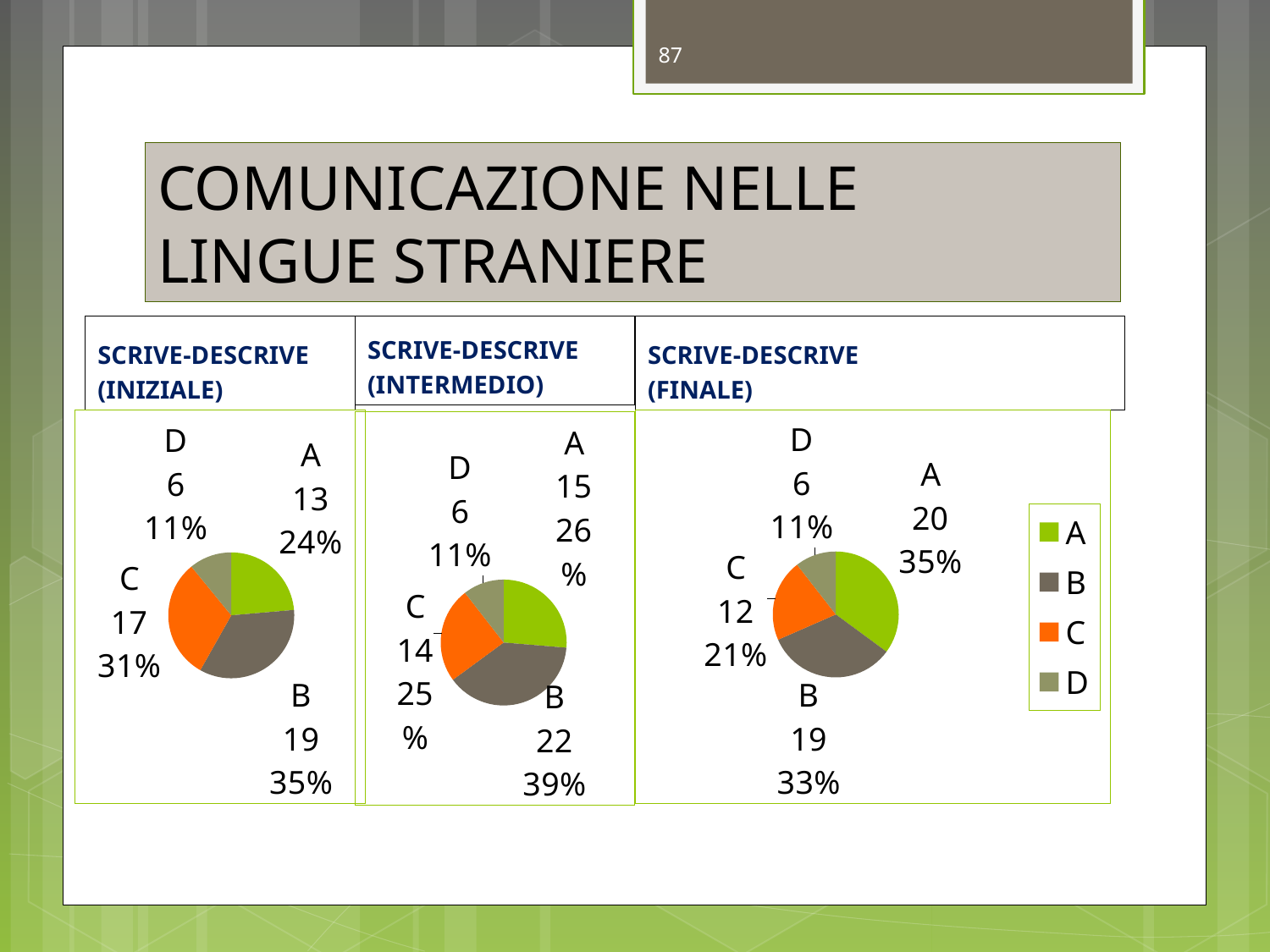
In the legend next to the SCRIVE-DESCRIVE (FINALE) chart, which category is shown in orange? C In the SCRIVE-DESCRIVE (FINALE) chart, which category has the smallest slice? D In the SCRIVE-DESCRIVE (INTERMEDIO) chart, what is the difference between the values for B and C? 8 In the SCRIVE-DESCRIVE (FINALE) chart, what percentage share does C have? 21% What kind of chart is used for SCRIVE-DESCRIVE (INTERMEDIO)? Pie chart In the SCRIVE-DESCRIVE (INTERMEDIO) chart, what percentage share does B have? 39% In the SCRIVE-DESCRIVE (FINALE) chart, which is larger, the value for A or the value for B? A In the SCRIVE-DESCRIVE (INIZIALE) chart, what is the value for C? 17 How many slices does the SCRIVE-DESCRIVE (INIZIALE) pie chart have? 4 In the SCRIVE-DESCRIVE (INIZIALE) chart, which category has the largest slice? B In the SCRIVE-DESCRIVE (FINALE) chart, what is the value for A? 20 How many entries does the legend next to the SCRIVE-DESCRIVE (FINALE) chart list? 4